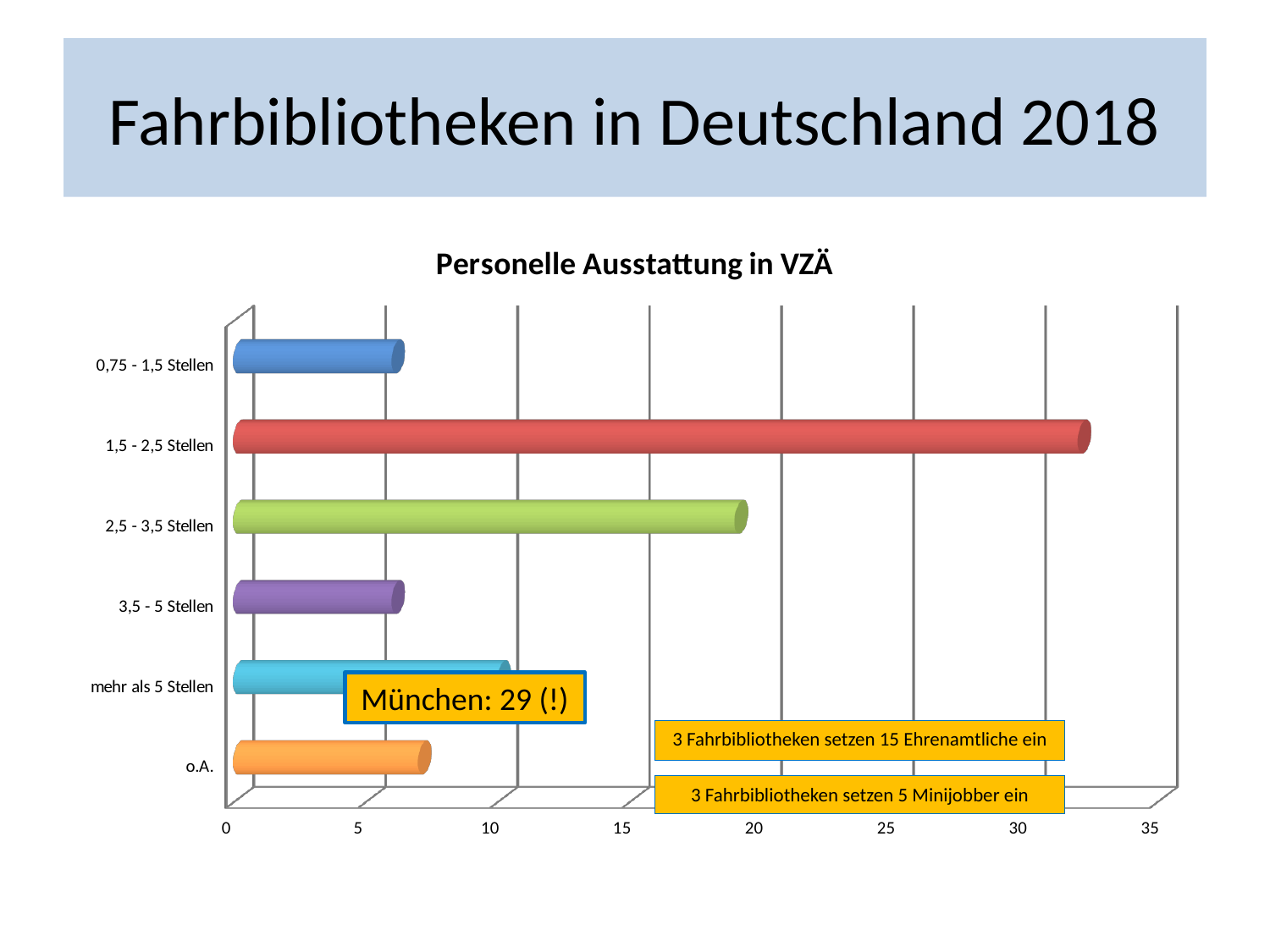
Is the value for o.A. greater or less than 5? greater Is the value for 2,5 - 3,5 Stellen greater or less than 20? less Is the value for 1,5 - 2,5 Stellen greater or less than 30? greater What is the maximum value shown on the horizontal axis? 35 How many categories are shown on the chart? 6 What is the title of the chart? Personelle Ausstattung in VZÄ Which category has the highest value? 1,5 - 2,5 Stellen Which is larger, the value for mehr als 5 Stellen or the value for o.A.? mehr als 5 Stellen What kind of chart is shown on the slide? bar chart Which is larger, the value for 2,5 - 3,5 Stellen or the value for mehr als 5 Stellen? 2,5 - 3,5 Stellen